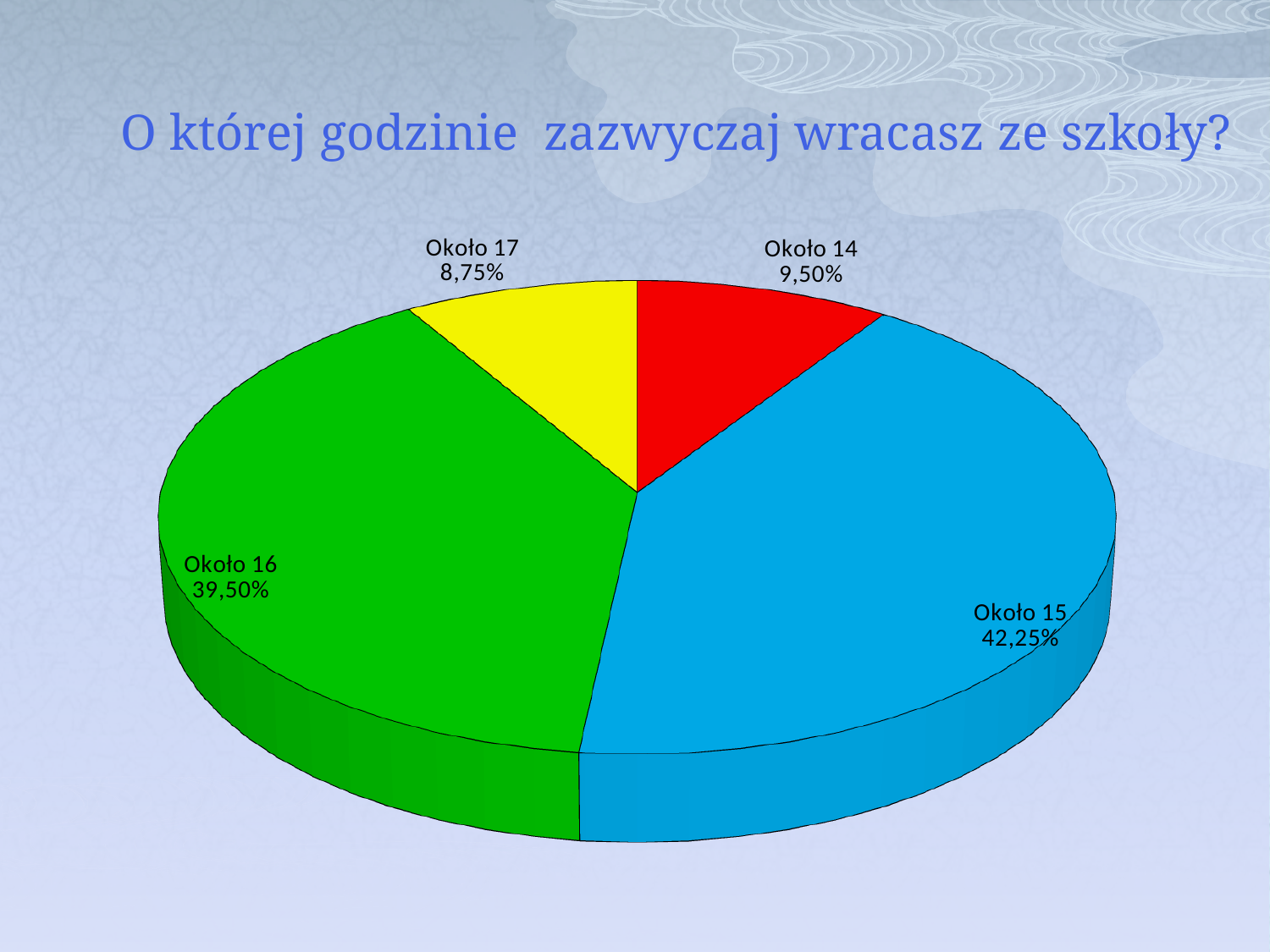
What is the value shown for "Około 16"? 39,50% Which category has the largest slice of the pie? Około 15 Which is larger, the value for "Około 14" or the value for "Około 17"? Około 14 What kind of chart is shown on the slide? Pie chart What is the difference between the values for "Około 15" and "Około 16"? 2,75% What is the value shown for "Około 17"? 8,75% Which category has the smallest slice of the pie? Około 17 What colour is the "Około 16" slice? Green What share of the pie does the "Około 15" slice represent? 42,25% How many categories are shown in the pie chart? 4 What is the difference between the values for "Około 14" and "Około 17"? 0,75% What is the value shown for "Około 14"? 9,50%